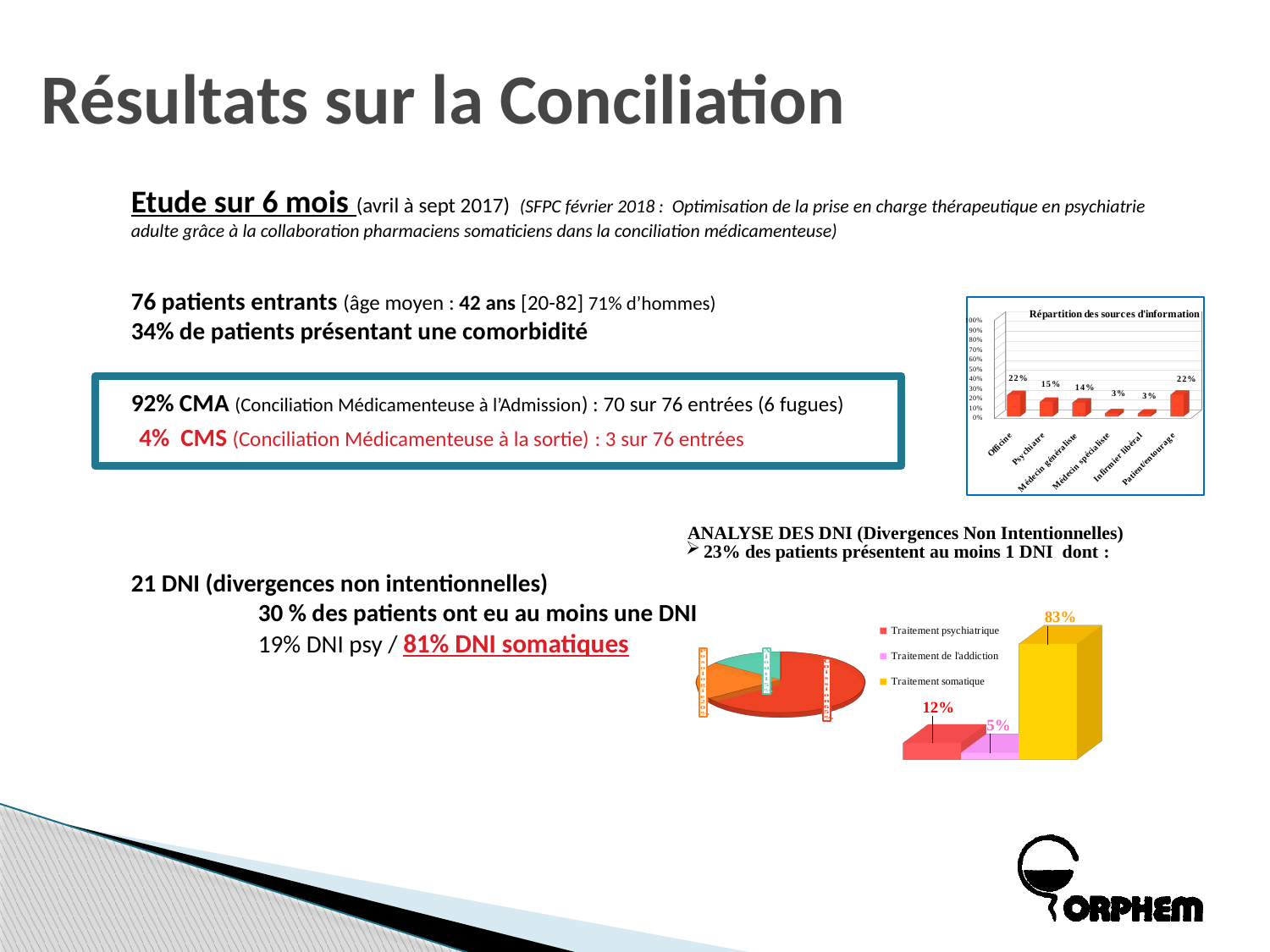
What kind of chart is the one titled "Répartition des sources d'information"? Bar chart In the chart titled "Répartition des sources d'information", what is the difference between the values for Officine and Psychiatre? 7% In the bar chart at the bottom right of the slide, what is the value for Traitement somatique? 83% How many entries does the legend of the bar chart at the bottom right of the slide list? 3 In the bar chart at the bottom right of the slide, what is the value for Traitement de l'addiction? 5% In the chart titled "Répartition des sources d'information", which is larger, Médecin généraliste or Médecin spécialiste? Médecin généraliste In the chart titled "Répartition des sources d'information", what is the value for Médecin généraliste? 14% In the bar chart at the bottom right of the slide, which treatment category has the highest value? Traitement somatique In the chart titled "Répartition des sources d'information", what is the value for Psychiatre? 15% In the chart titled "Répartition des sources d'information", how many categories are shown on the x axis? 6 In the chart titled "Répartition des sources d'information", what is the value for Officine? 22% In the chart titled "Répartition des sources d'information", what is the value for Infirmier libéral? 3%